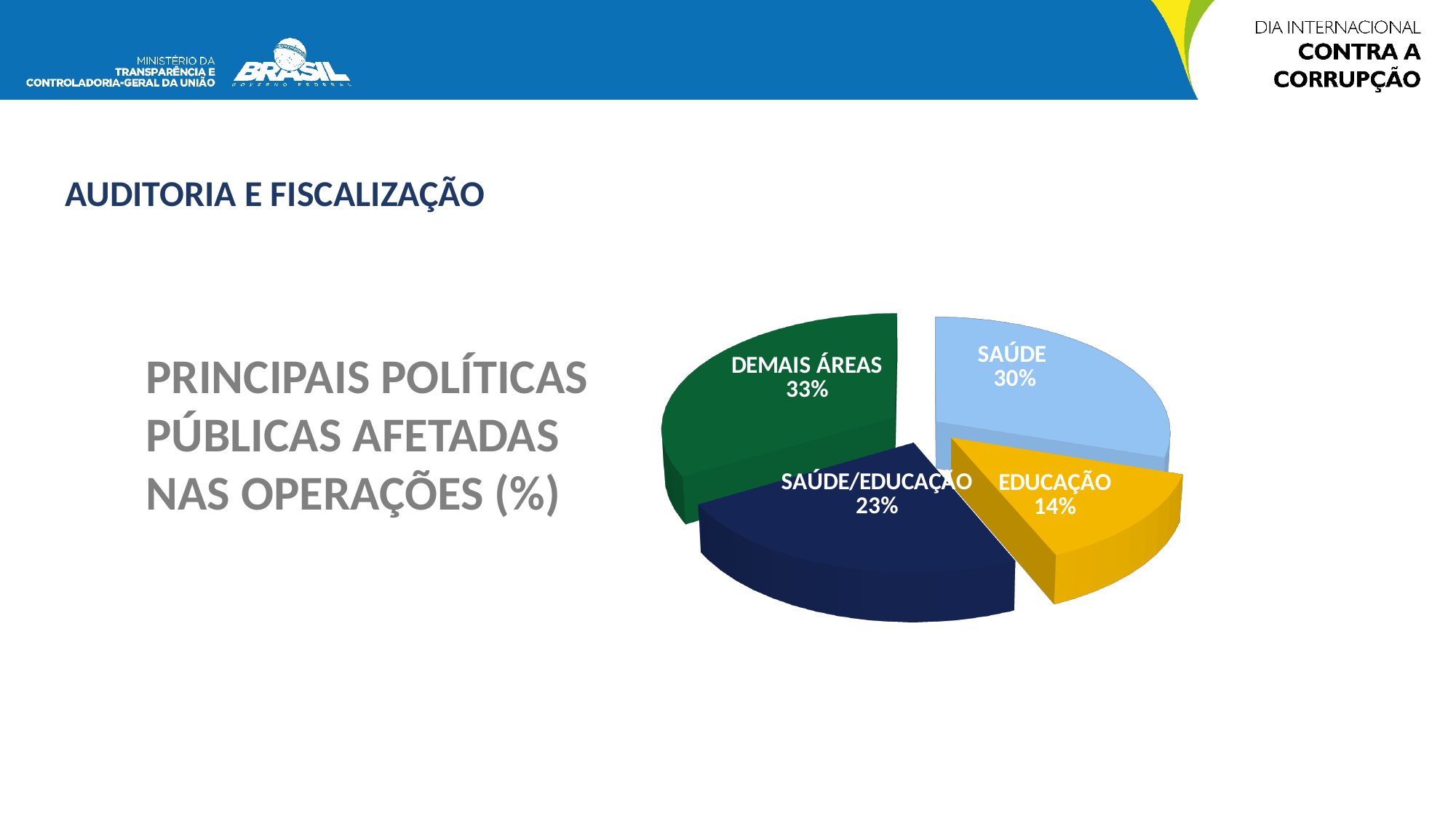
Which slice of the pie chart is the largest? DEMAIS ÁREAS Which is larger, SAÚDE or SAÚDE/EDUCAÇÃO? SAÚDE What percentage does the SAÚDE slice represent? 30% Which slice of the pie chart is the smallest? EDUCAÇÃO What percentage does the SAÚDE/EDUCAÇÃO slice represent? 23% What colour is the SAÚDE/EDUCAÇÃO slice? Dark navy blue What kind of chart is shown on the slide? Pie chart What is the combined share of SAÚDE and EDUCAÇÃO? 44% What is the difference in percentage points between DEMAIS ÁREAS and EDUCAÇÃO? 19 What percentage does the EDUCAÇÃO slice represent? 14% How many slices does the pie chart have? 4 What percentage does the DEMAIS ÁREAS slice represent? 33%